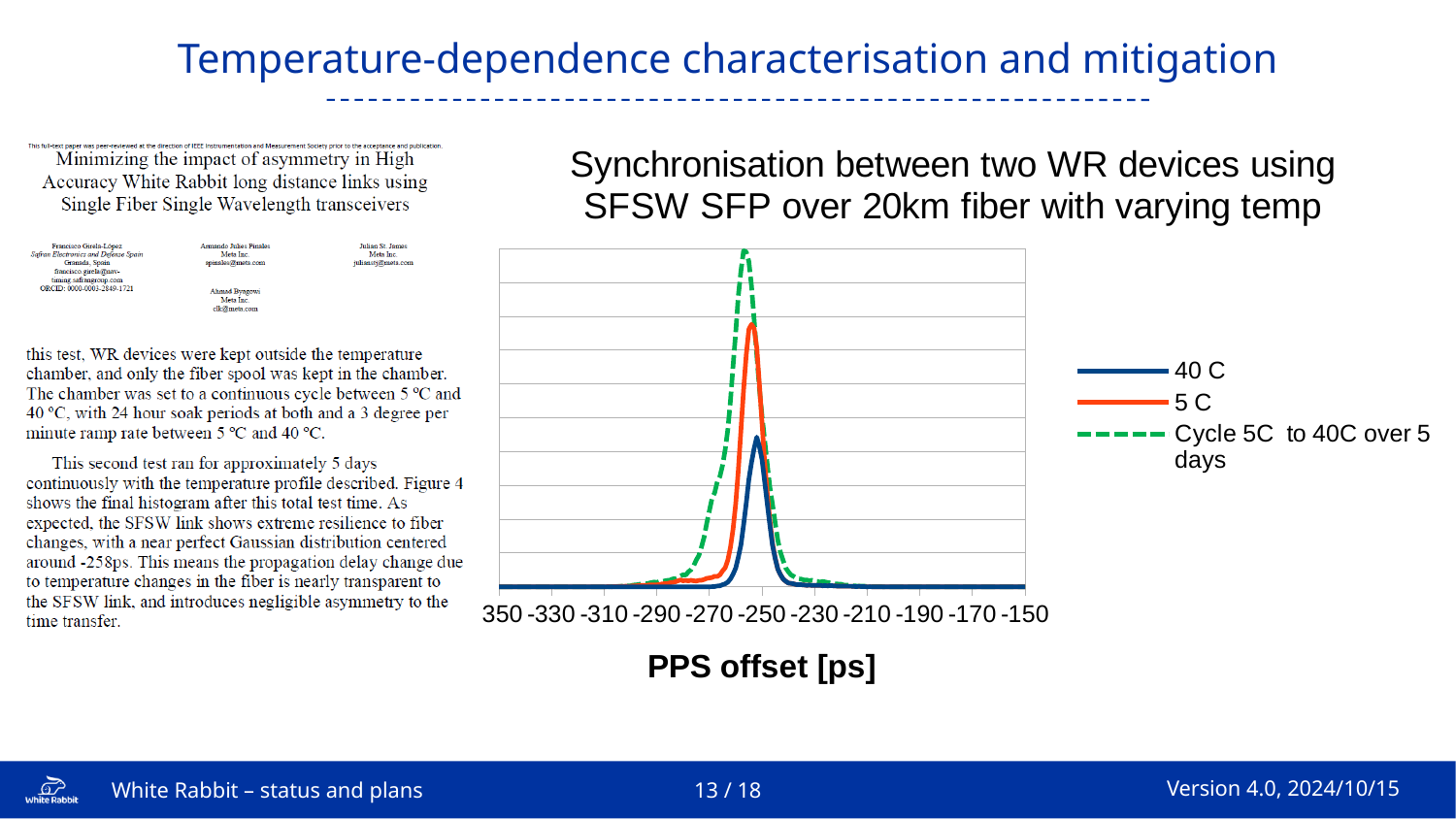
What is the title of the chart? Synchronisation between two WR devices using SFSW SFP over 20km fiber with varying temp Which series reaches a higher peak, 5 C or Cycle 5C to 40C over 5 days? Cycle 5C to 40C over 5 days Which series reaches a higher peak, 5 C or 40 C? 5 C Which series has the highest peak in the chart? Cycle 5C to 40C over 5 days How many series does the chart's legend list? 3 Which series has the lowest peak in the chart? 40 C What is the highest x-axis tick value shown on the chart? -150 Is the peak of the 40 C series located at an x value greater or less than -270? greater What kind of chart is shown on the slide? line chart What is the lowest x-axis tick value shown on the chart? -350 What is the label of the x axis of the chart? PPS offset [ps] How many tick labels are shown on the x axis of the chart? 11